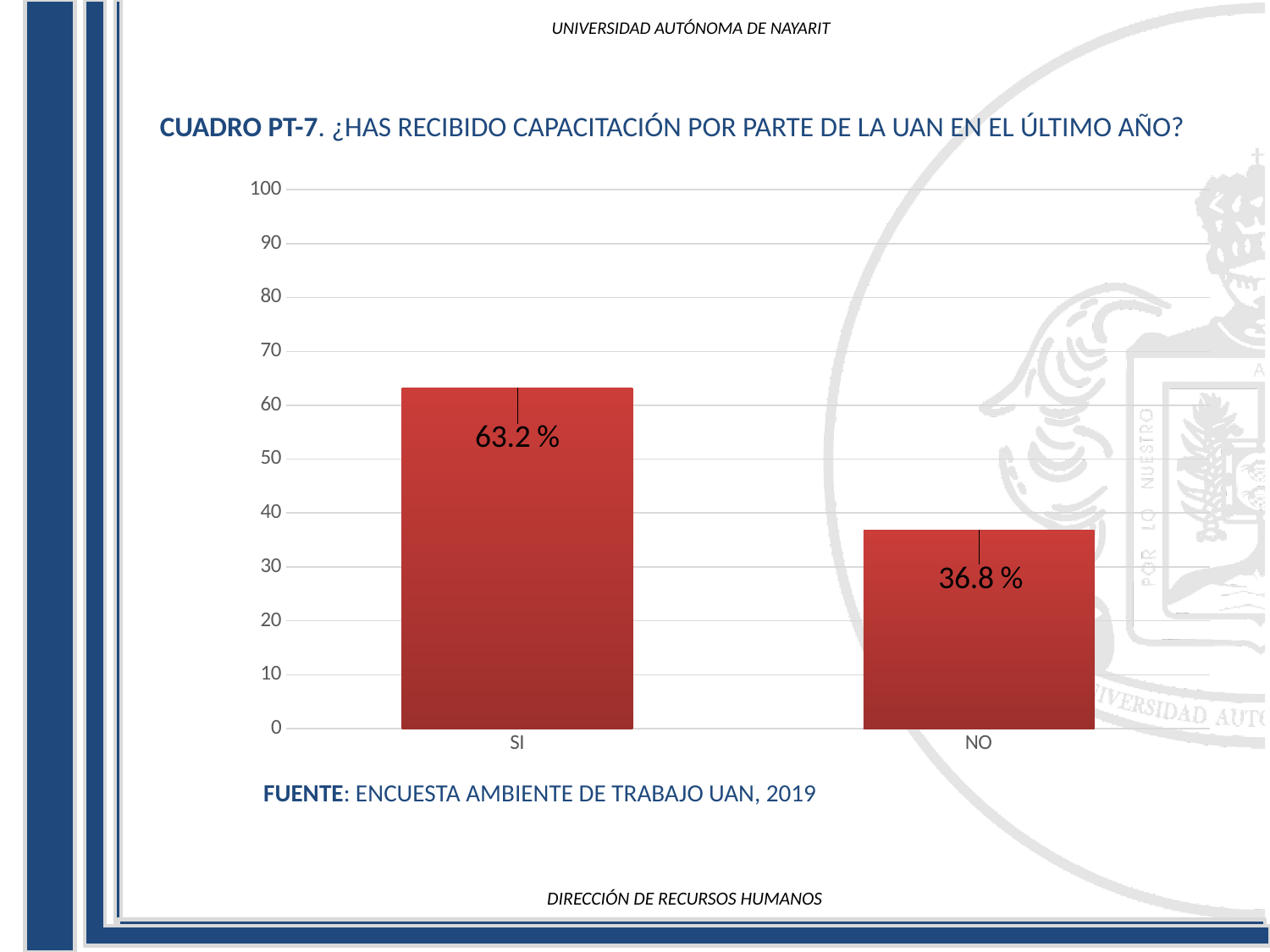
Is the value for SI greater or less than 60? greater What is the maximum value shown on the y axis? 100 What is the value for NO? 36.8 % Which is larger, the value for SI or the value for NO? SI How many categories are shown on the x axis? 2 Is the value for NO greater or less than 40? less What kind of chart is shown on the slide? bar chart Which category has the highest value? SI What is the difference between the values for SI and NO? 26.4 % Which category has the lowest value? NO What is the value for SI? 63.2 % What source is cited below the chart? ENCUESTA AMBIENTE DE TRABAJO UAN, 2019